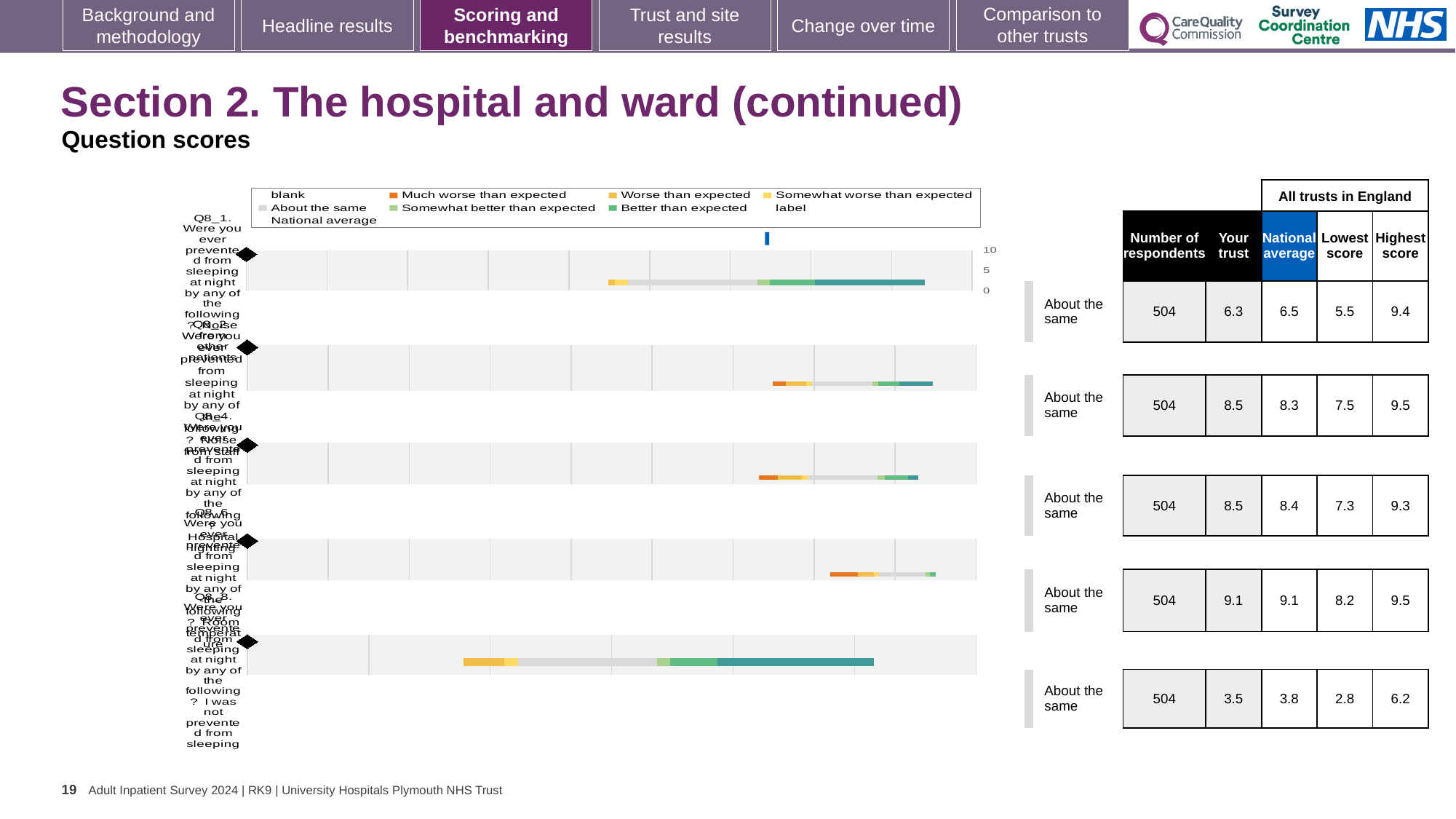
What benchmark rating is shown next to each of the five question rows? About the same Which question row has the highest 'Your trust' score? Q8_6 What is the national average for Q8_8 in the table beside the chart? 3.8 What is the 'Your trust' score for Q8_1 in the table beside the chart? 6.3 What is the lowest score across all trusts in England for Q8_4? 7.3 How many respondents are listed for Q8_6? 504 Which question row has the lowest 'Your trust' score? Q8_8 How many question rows (bars) are plotted in the chart? 5 For Q8_1, which is larger: the 'Your trust' score or the national average? National average What kind of chart is shown on the slide? bar chart What is the difference between the highest score and the lowest score for Q8_8? 3.4 What is the highest score across all trusts in England for Q8_2? 9.5